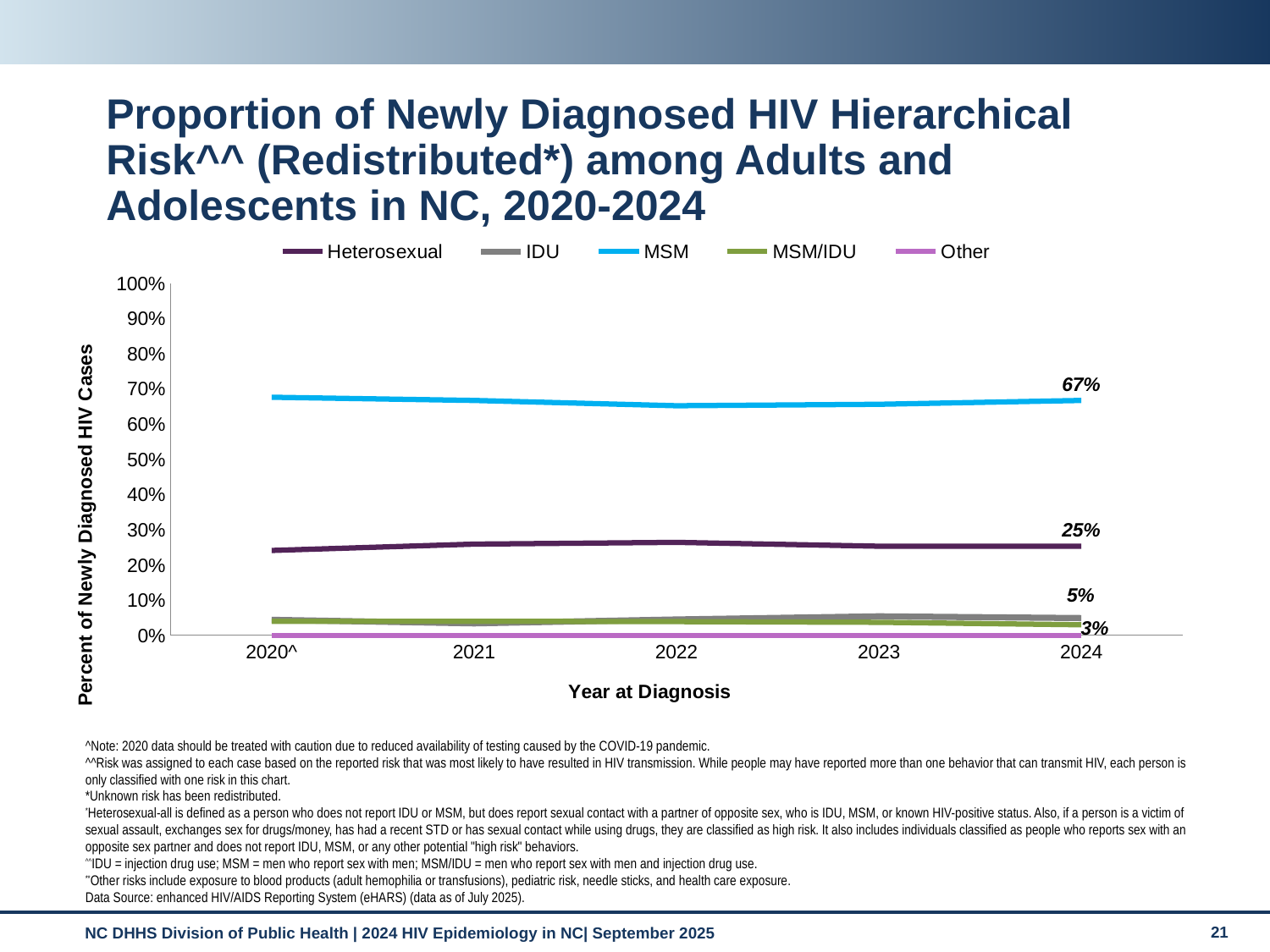
What is the value for Heterosexual in 2024? 25% Is the value for MSM in 2020 greater or less than 60%? greater In 2024, which is larger, the value for MSM or the value for Heterosexual? MSM What is the difference between the MSM and Heterosexual values in 2024? 42 percentage points What is the label of the x axis? Year at Diagnosis How many series does the legend list? 5 What is the value for MSM in 2024? 67% What type of chart is shown on the slide? line chart How many years are shown on the x axis? 5 Is the value for Heterosexual in 2022 greater or less than 40%? less Which risk category has the highest proportion in 2024? MSM Which risk category has the lowest proportion in 2024? Other